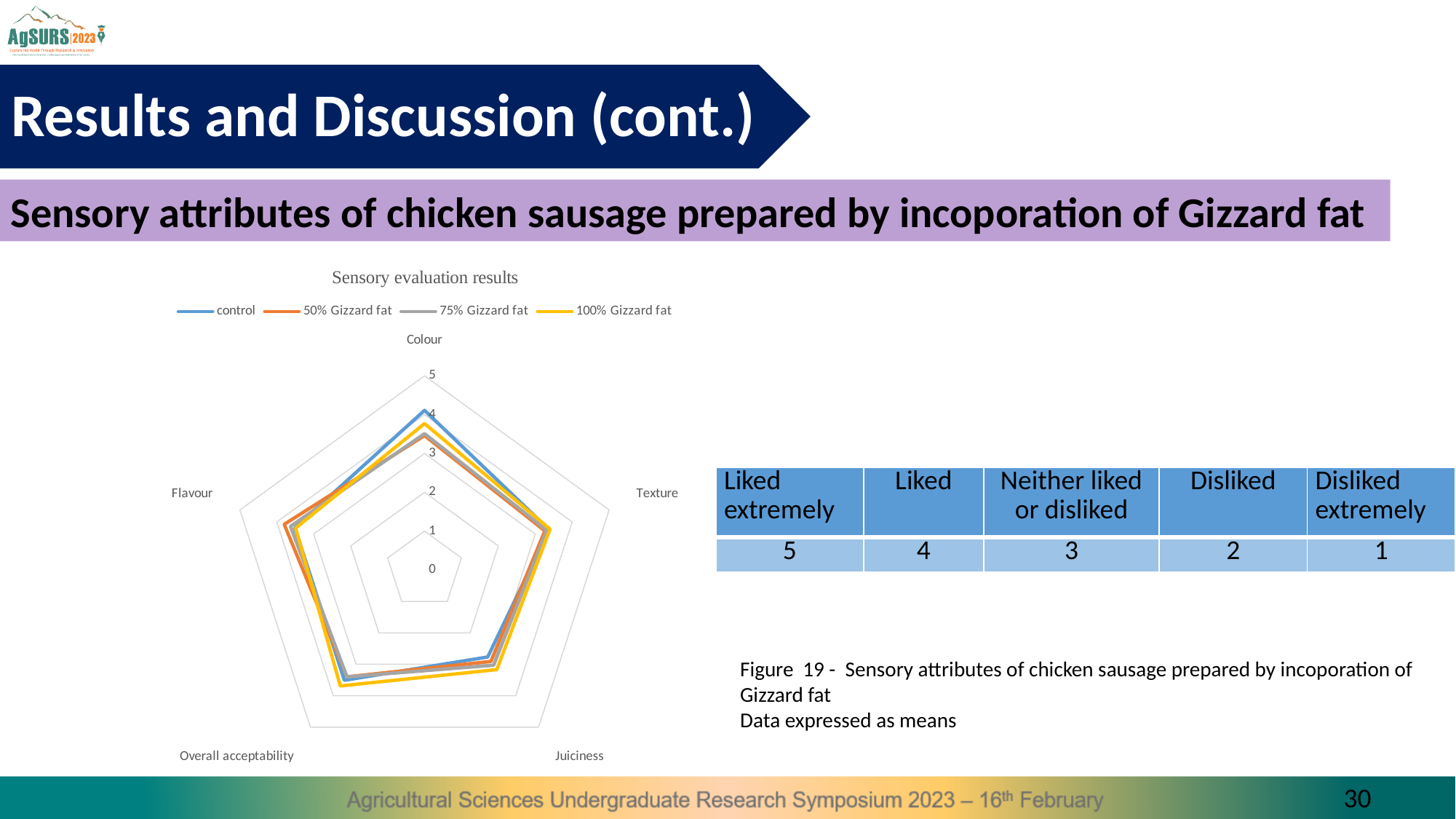
Is the value for Colour in the control series greater or less than 3? greater How many sensory attributes (axes) are plotted on the chart? 5 What kind of chart is shown on the slide? Radar chart What is the title of the chart? Sensory evaluation results What is the maximum value shown on the chart's scale? 5 Is the value for Overall acceptability in the 100% Gizzard fat series greater or less than 5? less Which series are listed in the chart legend? control, 50% Gizzard fat, 75% Gizzard fat, 100% Gizzard fat Which series has the highest value for Colour? control Is the value for Texture in the 100% Gizzard fat series greater or less than 3? greater Which is larger for Colour: the control series or the 75% Gizzard fat series? control How many series does the chart legend list? 4